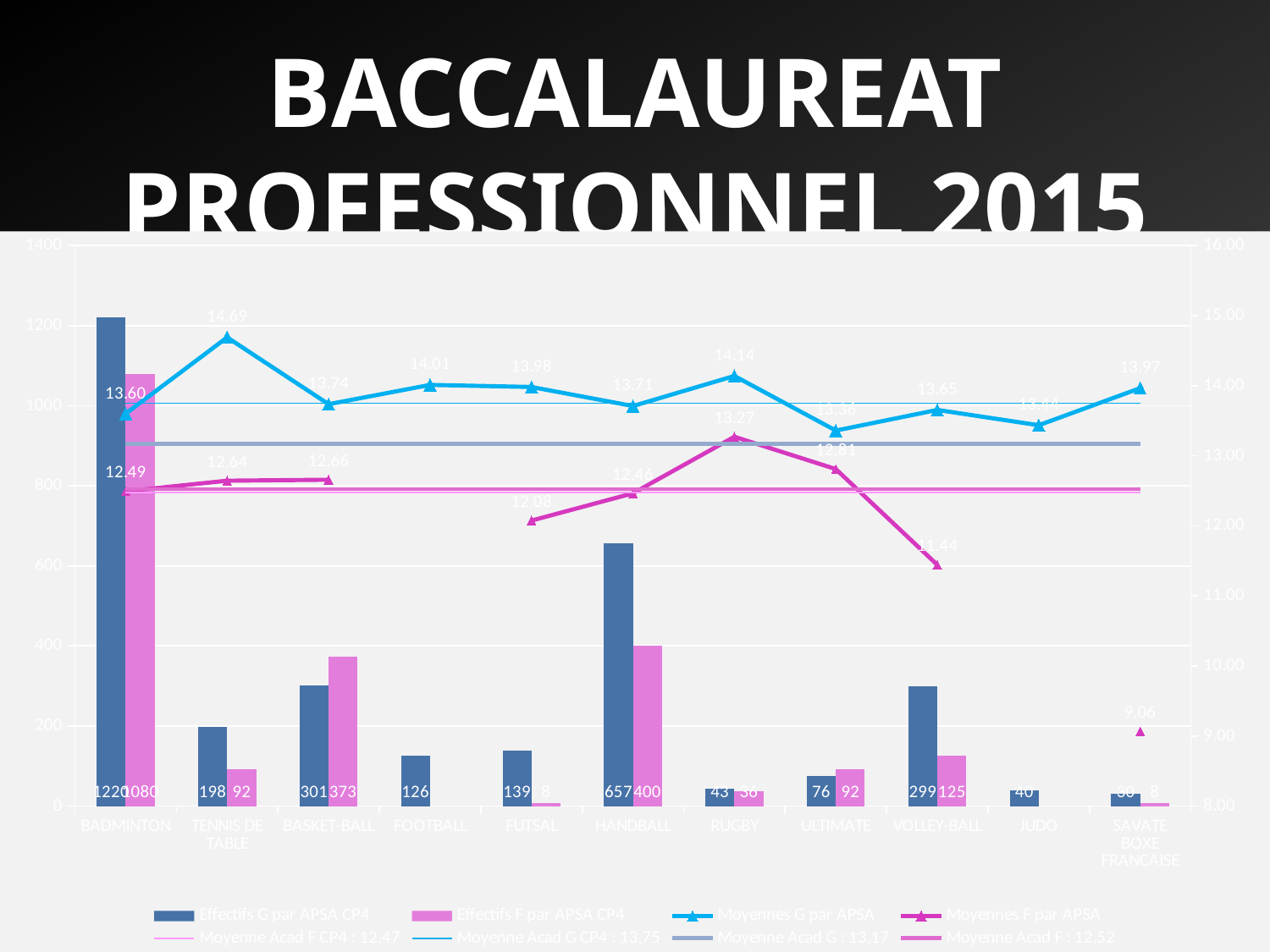
What kind of chart is shown on the slide? A combined bar and line chart What is the value of Effectifs G par APSA CP4 for HANDBALL? 657 What is the Moyennes G par APSA value for RUGBY? 14.14 How many series does the legend list? 8 Which sport has the lowest Moyennes F par APSA value? SAVATE BOXE FRANCAISE How many sports categories are shown on the x axis? 11 Which sport has the highest Effectifs G par APSA CP4 value? BADMINTON Which sport has the highest Moyennes G par APSA value? TENNIS DE TABLE What is the value of Effectifs F par APSA CP4 for BASKET-BALL? 373 What is the Moyennes F par APSA value for ULTIMATE? 12.81 What is the difference between Effectifs G and Effectifs F for BADMINTON? 140 For BASKET-BALL, which is larger: Effectifs G par APSA CP4 or Effectifs F par APSA CP4? Effectifs F par APSA CP4